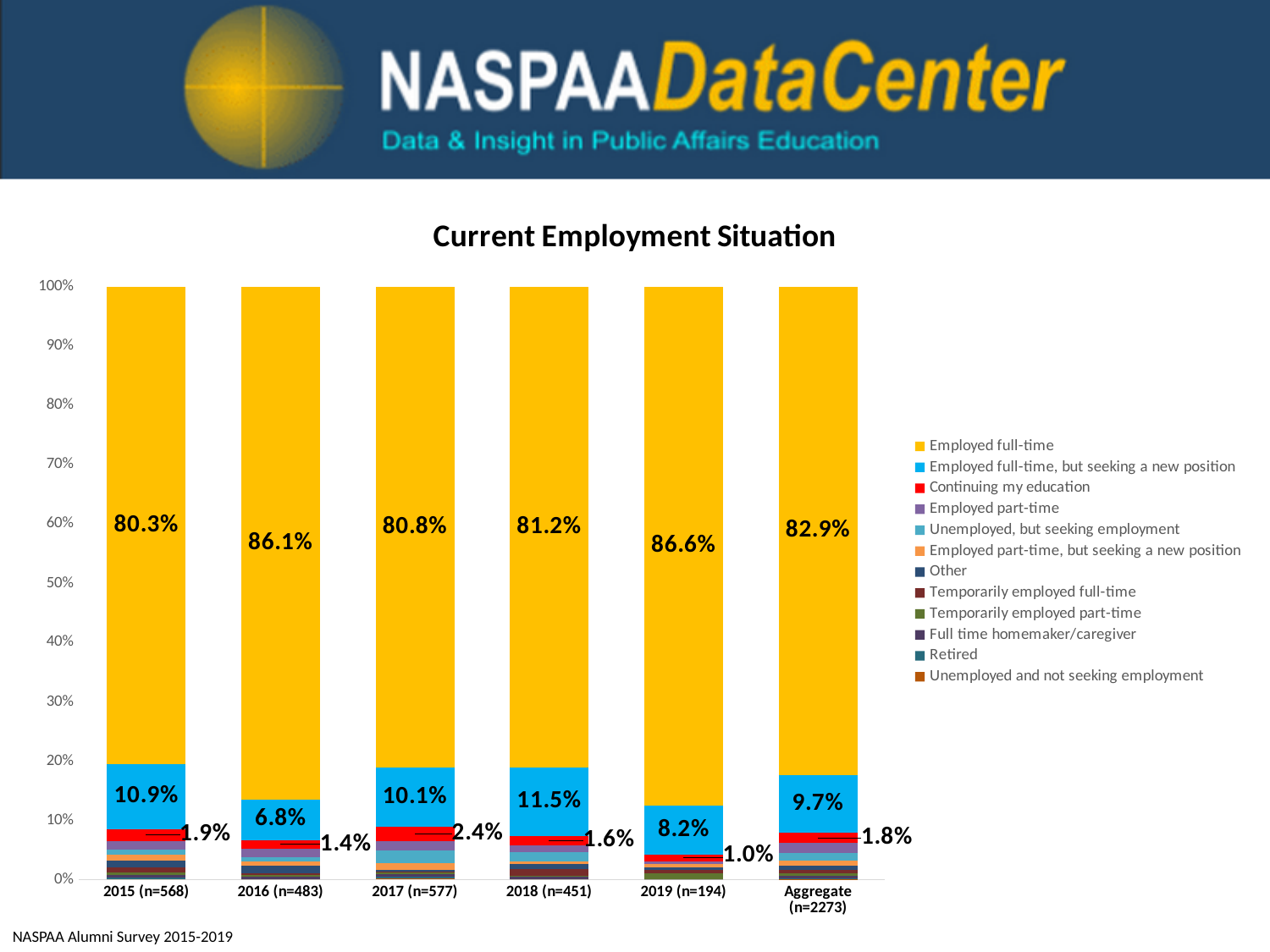
Is the Employed full-time value for 2018 (n=451) greater or less than 90%? less What is the difference between the Employed full-time values for 2016 (n=483) and 2015 (n=568)? 5.8% How many series does the legend list? 12 What is the Employed full-time, but seeking a new position value for 2018 (n=451)? 11.5% Which category has the lowest Employed full-time, but seeking a new position value? 2016 (n=483) What type of chart is shown on the slide? Stacked bar chart What is the Employed full-time value for 2017 (n=577)? 80.8% Which year has the highest Employed full-time share? 2019 (n=194) What is the Employed full-time value for Aggregate (n=2273)? 82.9% Which is larger: the Employed full-time, but seeking a new position value for 2015 (n=568) or for 2019 (n=194)? 2015 (n=568) What is the title of the chart? Current Employment Situation How many bars (categories) are shown on the x axis? 6